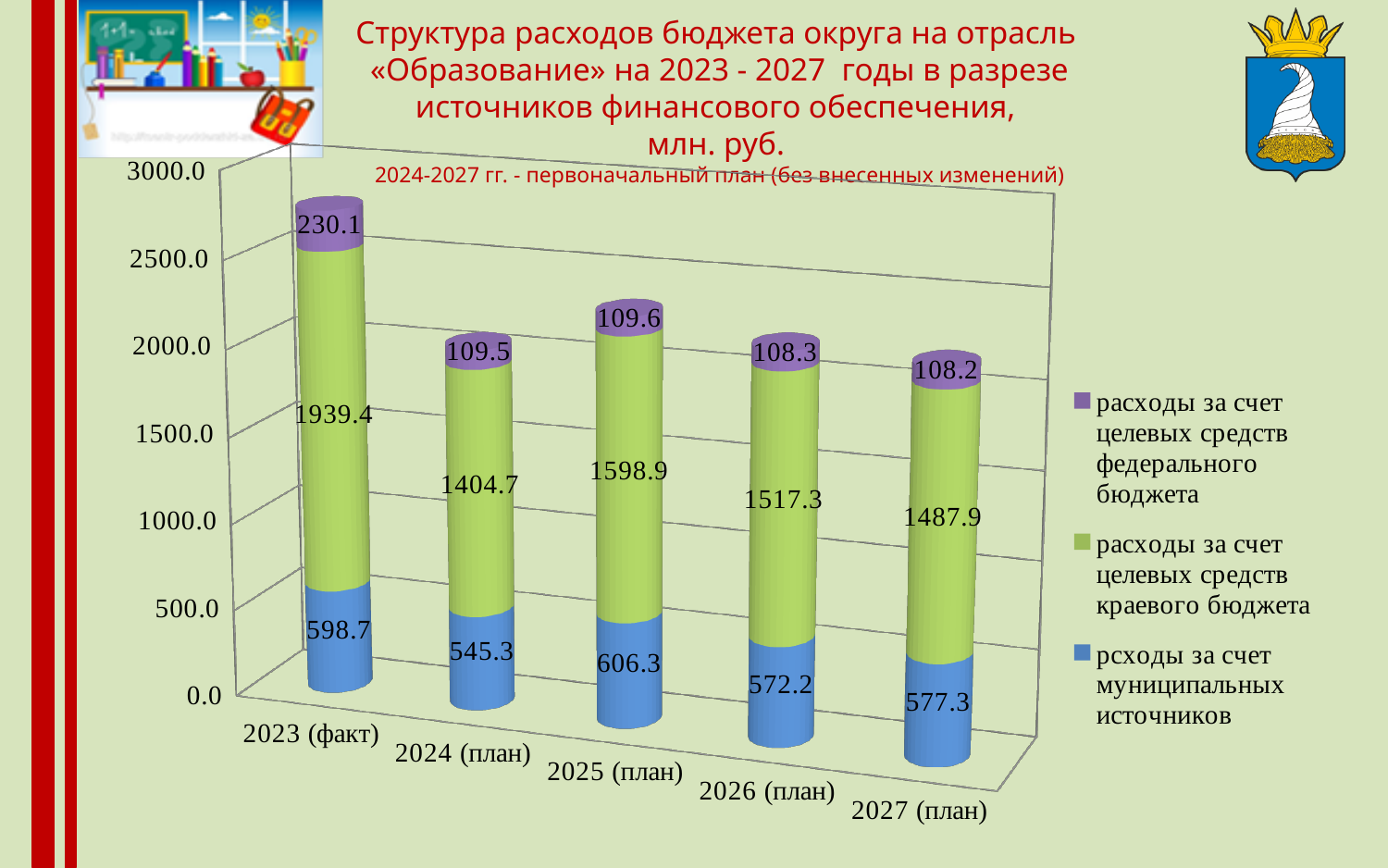
What is the total of the stacked bar for 2024 (план)? 2059.5 What is the value of расходы за счет муниципальных источников for 2027 (план)? 577.3 What kind of chart is shown on the slide? Stacked bar chart Which year has the lowest value for расходы за счет муниципальных источников? 2024 (план) Which year has the highest value for расходы за счет целевых средств федерального бюджета? 2023 (факт) What colour represents расходы за счет целевых средств краевого бюджета in the chart? Green How many series does the legend list? 3 Which is larger: the муниципальных источников value for 2025 (план) or for 2026 (план)? 2025 (план) What is the value of расходы за счет целевых средств федерального бюджета for 2025 (план)? 109.6 How many years are shown on the x axis? 5 What is the value of расходы за счет целевых средств краевого бюджета for 2023 (факт)? 1939.4 What is the difference between the краевого бюджета values for 2023 (факт) and 2024 (план)? 534.7